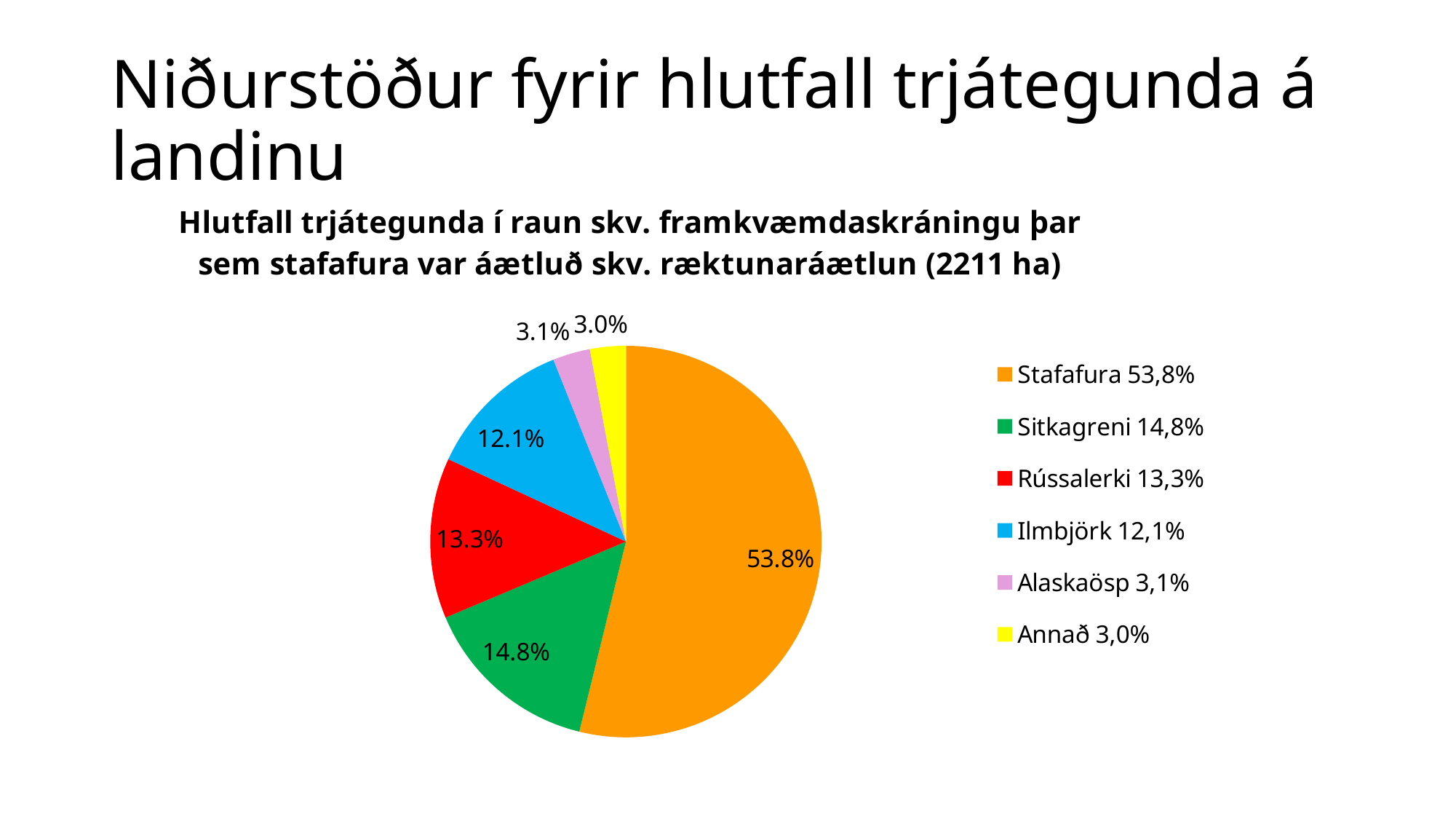
What share of the pie does Stafafura have? 53.8% What is the value shown for Rússalerki? 13.3% What kind of chart is shown on the slide? pie chart What is the value shown for Ilmbjörk? 12.1% What is the value shown for Sitkagreni? 14.8% Which tree species has the largest share of the pie? Stafafura Which has a larger share, Alaskaösp or Annað? Alaskaösp What colour is the Ilmbjörk slice? blue What is the difference between the shares of Sitkagreni and Rússalerki? 1.5% Which category has the smallest share of the pie? Annað What area in hectares is mentioned in the chart title? 2211 ha How many slices does the pie chart have? 6